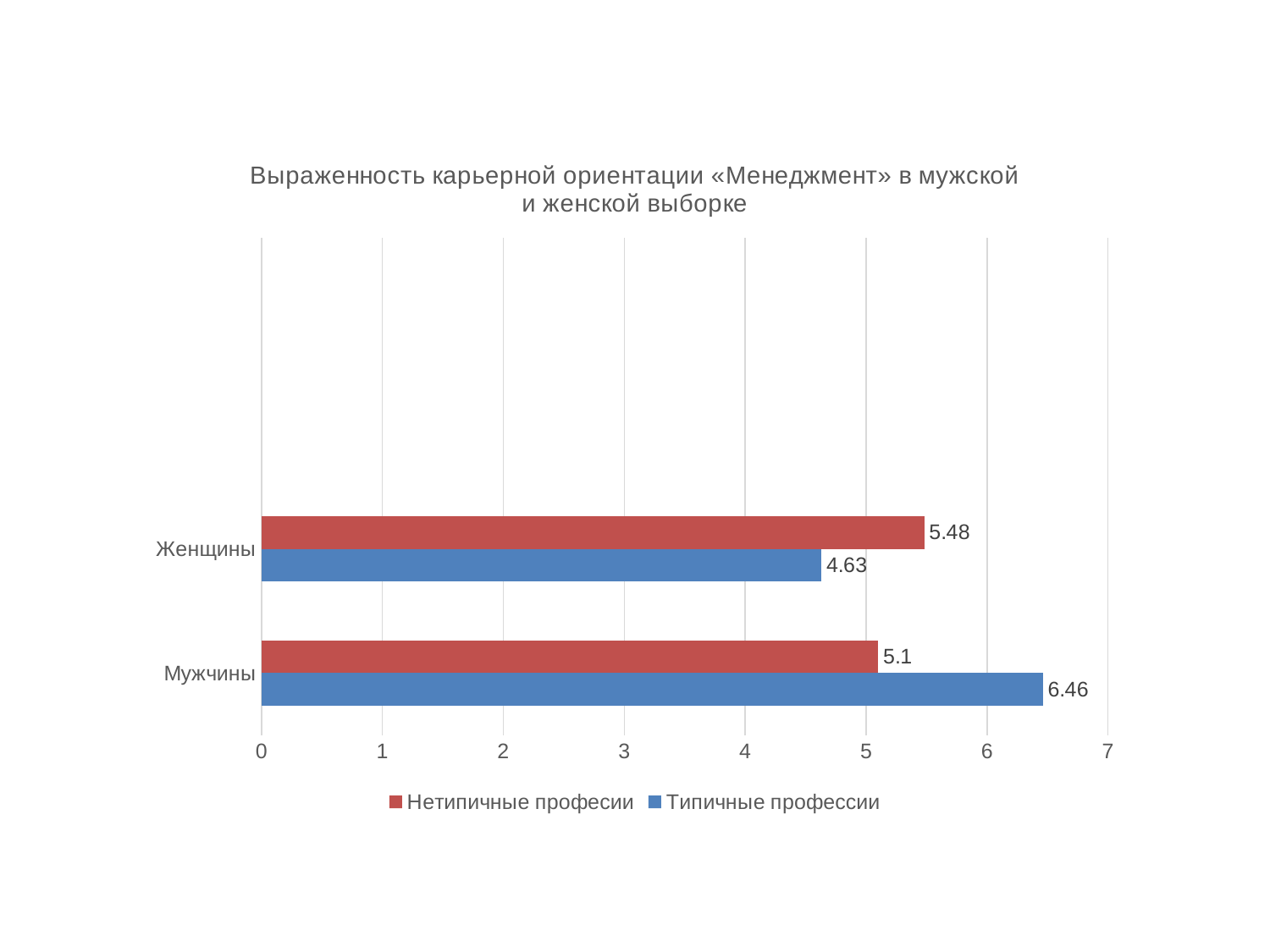
What is the value for Женщины in the Типичные профессии series? 4.63 What is the difference between the Типичные профессии values for Мужчины and Женщины? 1.83 Which category has the lowest value in the Типичные профессии series? Женщины What is the value for Мужчины in the Типичные профессии series? 6.46 How many series does the legend list? 2 What is the value for Женщины in the Нетипичные професии series? 5.48 What kind of chart is shown on the slide? Bar chart For Женщины, which series has the larger value: Нетипичныепрофесии or Типичные профессии? Нетипичные професии Which category has the highest value in the Типичные профессии series? Мужчины How many categories are shown on the chart? 2 For Мужчины, which series has the larger value: Нетипичные професии or Типичные профессии? Типичные профессии What is the value for Мужчины in the Нетипичные професии series? 5.1